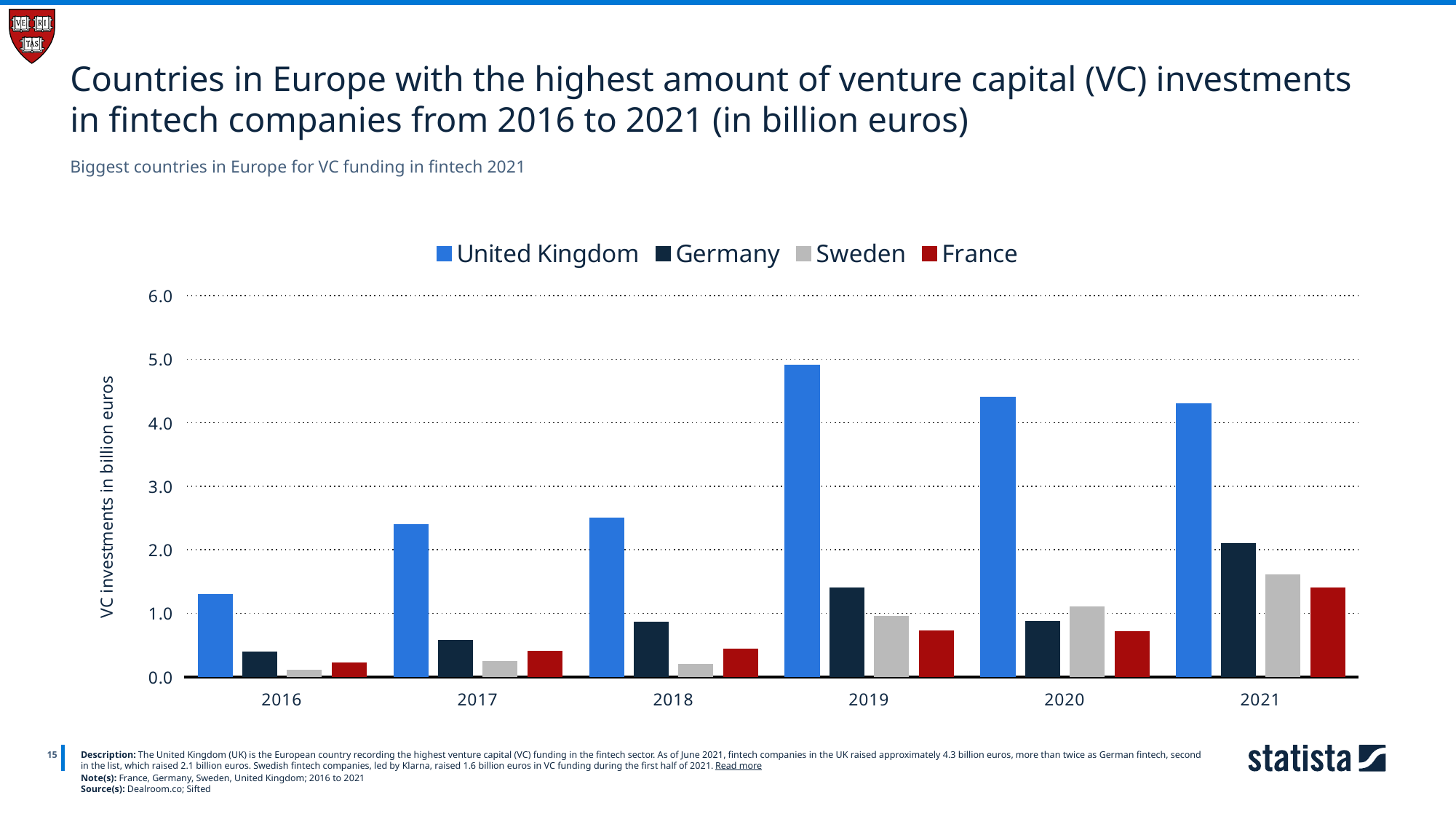
What kind of chart is shown on the slide? bar chart How many series does the legend list? 4 Do the United Kingdom values rise or fall from 2016 to 2019? rise Is the value for the United Kingdom in 2017 greater or less than 2.0? greater Is the value for the United Kingdom in 2019 greater or less than 4.0? greater Is the value for Sweden in 2016 greater or less than 1.0? less In 2021, which is larger: the value for Germany or the value for Sweden? Germany In which year is the United Kingdom bar the highest? 2019 What is the label of the y axis? VC investments in billion euros How many years are shown on the x axis? 6 Which country has the highest bar in 2021? United Kingdom In which year is the United Kingdom bar the lowest? 2016